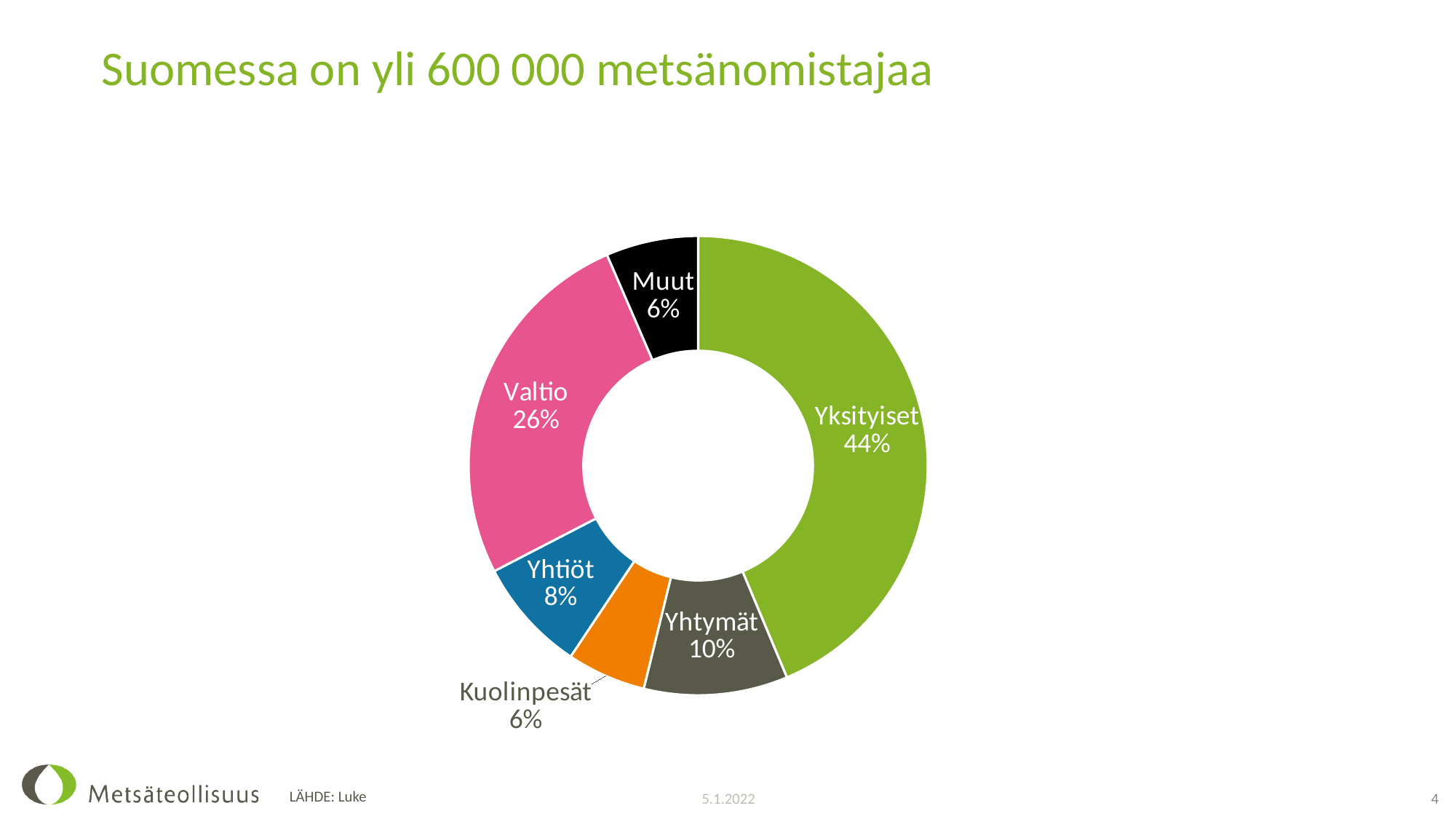
Which category has the largest share of the chart? Yksityiset What is the value shown for Valtio? 26% What percentage is shown for Yhtymät? 10% What kind of chart is shown on the slide? Pie chart (doughnut) Which is larger, the share for Yhtymät or the share for Yhtiöt? Yhtymät What is the difference in percentage points between Yksityiset and Valtio? 18 What is the value for Yhtiöt? 8% What is the combined share of Muut and Kuolinpesät? 12% What share of the chart does Yksityiset hold? 44% What share is shown for Kuolinpesät? 6% What is the title of the slide? Suomessa on yli 600 000 metsänomistajaa How many categories are shown in the chart? 6